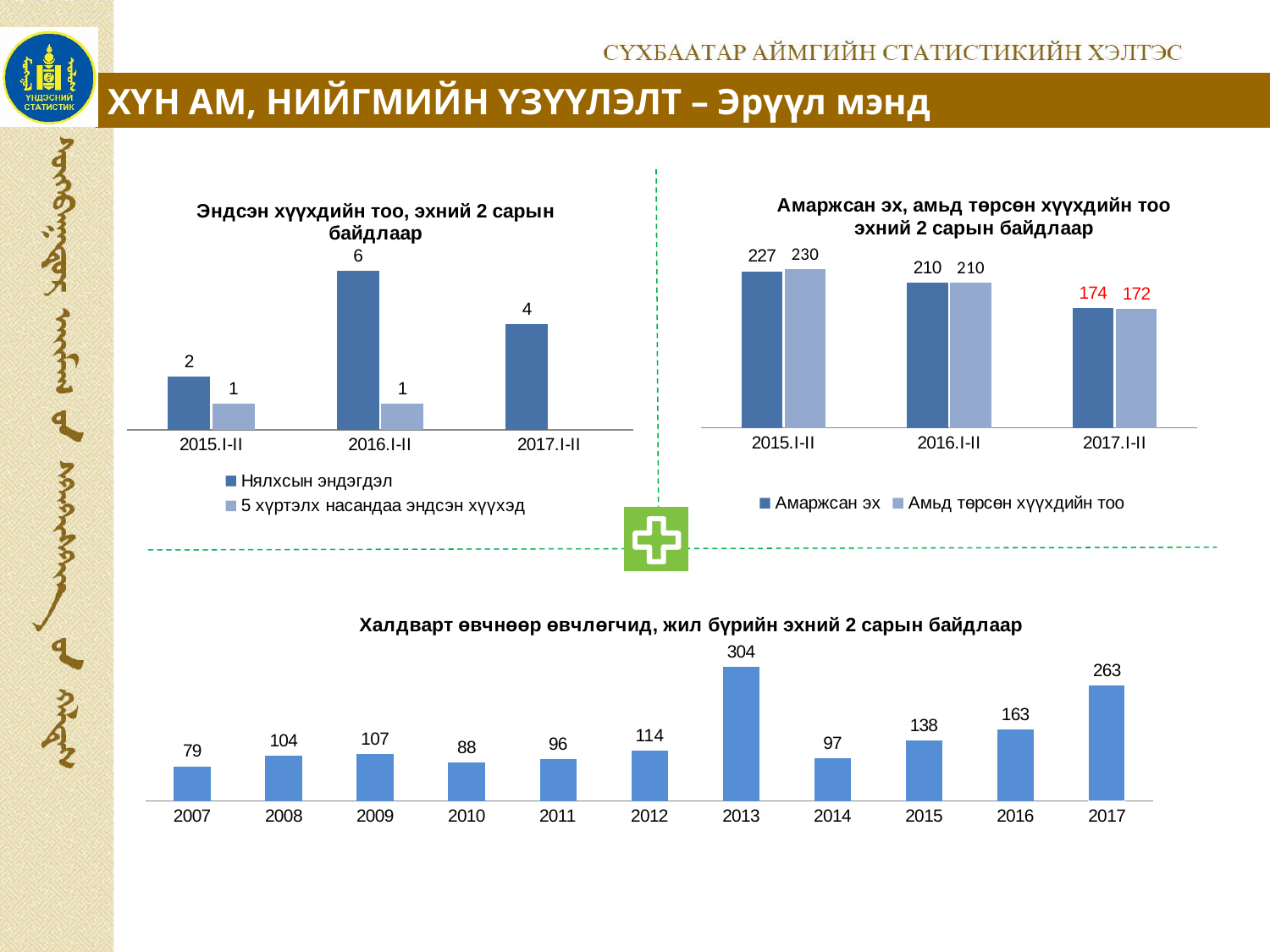
In the bottom chart 'Халдварт өвчнөөр өвчлөгчид, жил бүрийн эхний 2 сарын байдлаар', which is larger, the value for 2010 or the value for 2011? 2011 In the top-right chart 'Амаржсан эх, амьд төрсөн хүүхдийн тоо эхний 2 сарын байдлаар', what is the value of 'Амьд төрсөн хүүхдийн тоо' for 2015.I-II? 230 What kind of chart is the top-left chart 'Эндсэн хүүхдийн тоо, эхний 2 сарын байдлаар'? bar chart In the bottom chart 'Халдварт өвчнөөр өвчлөгчид, жил бүрийн эхний 2 сарын байдлаар', which year has the lowest value? 2007 In the top-left chart 'Эндсэн хүүхдийн тоо, эхний 2 сарын байдлаар', what is the value of 'Нялхсын эндэгдэл' for 2016.I-II? 6 In the top-left chart 'Эндсэн хүүхдийн тоо, эхний 2 сарын байдлаар', which period has the highest value for 'Нялхсын эндэгдэл'? 2016.I-II In the top-right chart 'Амаржсан эх, амьд төрсөн хүүхдийн тоо эхний 2 сарын байдлаар', what is the value of 'Амаржсан эх' for 2017.I-II? 174 How many series does the legend list in the top-right chart 'Амаржсан эх, амьд төрсөн хүүхдийн тоо эхний 2 сарын байдлаар'? 2 In the bottom chart 'Халдварт өвчнөөр өвчлөгчид, жил бүрийн эхний 2 сарын байдлаар', what is the value for 2013? 304 How many years are shown on the x axis of the bottom chart 'Халдварт өвчнөөр өвчлөгчид, жил бүрийн эхний 2 сарын байдлаар'? 11 In the top-right chart 'Амаржсан эх, амьд төрсөн хүүхдийн тоо эхний 2 сарын байдлаар', does the 'Амаржсан эх' series rise or fall from 2015.I-II to 2017.I-II? fall In the bottom chart 'Халдварт өвчнөөр өвчлөгчид, жил бүрийн эхний 2 сарын байдлаар', what is the difference between the values for 2017 and 2016? 100